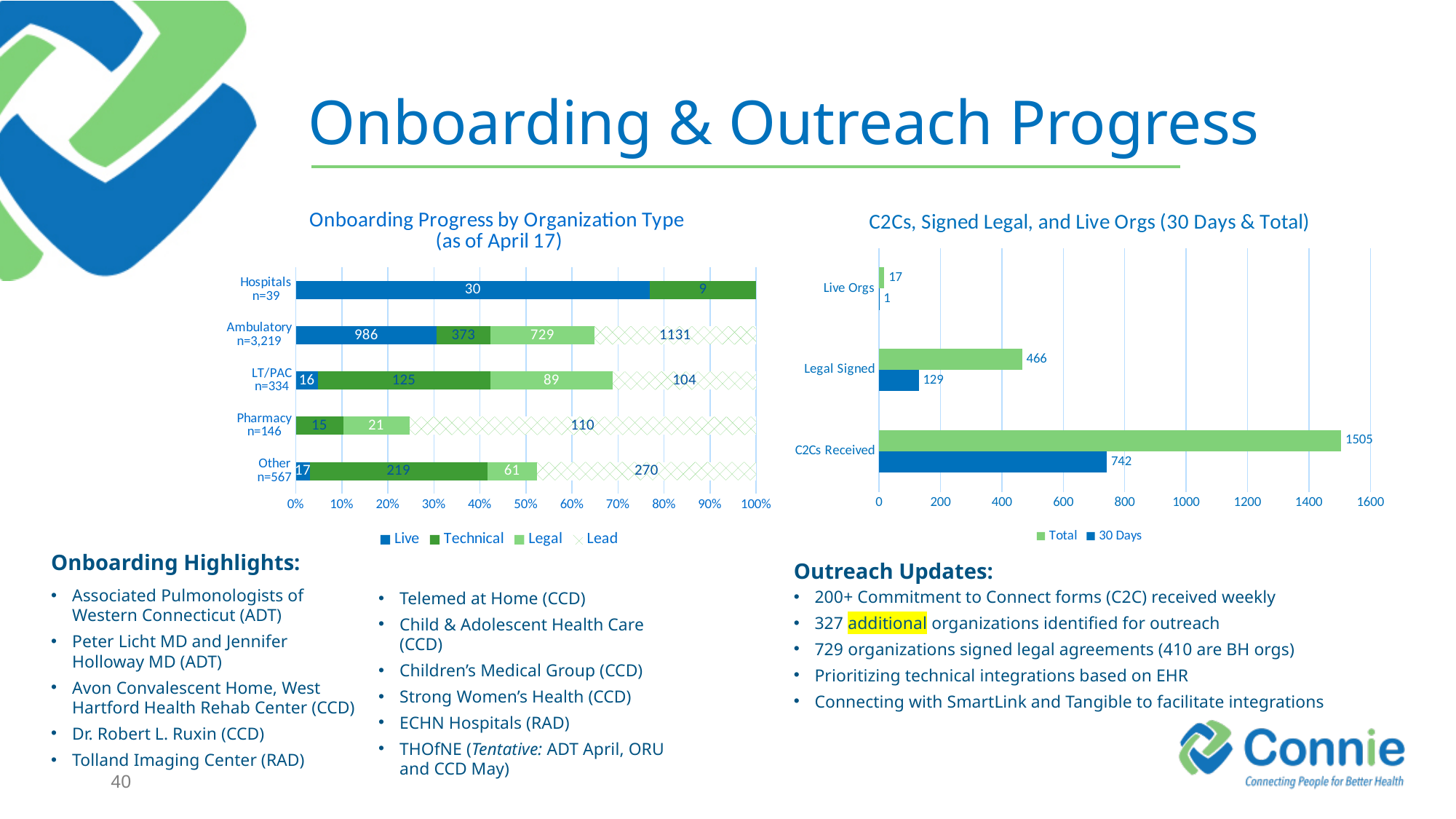
In the 'Onboarding Progress by Organization Type' chart, how many series does the legend list? 4 In the 'Onboarding Progress by Organization Type' chart, what is the Live value for Ambulatory? 986 In the 'C2Cs, Signed Legal, and Live Orgs (30 Days & Total)' chart, what is the difference between the Total and 30 Days values for C2Cs Received? 763 In the 'Onboarding Progress by Organization Type' chart, what is the Technical value for LT/PAC? 125 What kind of chart is 'C2Cs, Signed Legal, and Live Orgs (30 Days & Total)'? Bar chart In the 'C2Cs, Signed Legal, and Live Orgs (30 Days & Total)' chart, which category has the highest Total value? C2Cs Received In the 'Onboarding Progress by Organization Type' chart, what is the difference between the Legal values for Ambulatory and LT/PAC? 640 In the 'Onboarding Progress by Organization Type' chart, how many organization types are shown? 5 In the 'Onboarding Progress by Organization Type' chart, what is the Lead value for Other? 270 In the 'C2Cs, Signed Legal, and Live Orgs (30 Days & Total)' chart, what is the 30 Days value for Legal Signed? 129 In the 'C2Cs, Signed Legal, and Live Orgs (30 Days & Total)' chart, what is the Total value for C2Cs Received? 1505 In the 'C2Cs, Signed Legal, and Live Orgs (30 Days & Total)' chart, which series is shown in green? Total